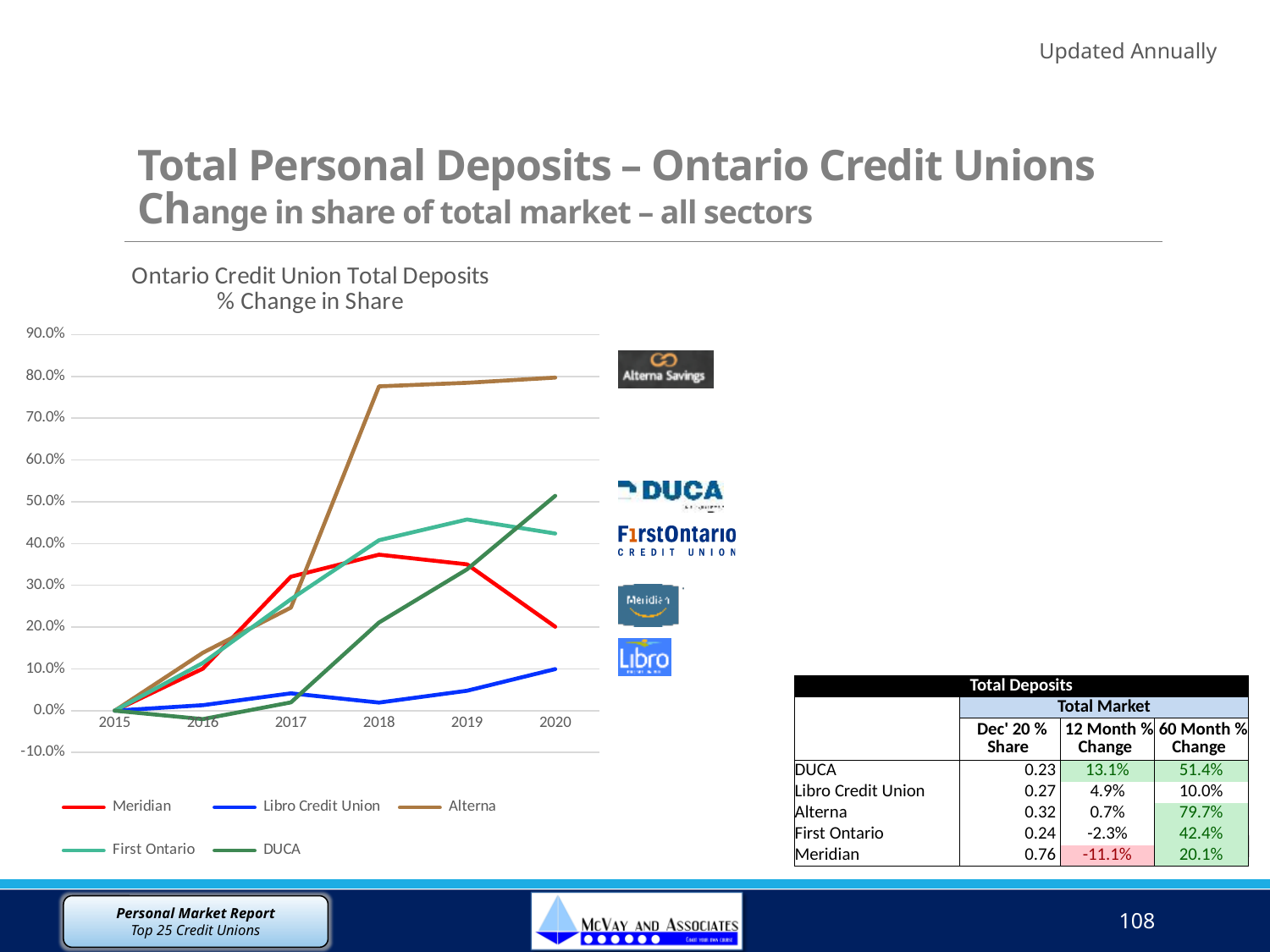
What kind of chart is shown on the slide? line chart Which series has the lowest value in 2020? Libro Credit Union Which series has the highest value in 2020? Alterna What is the title of the chart? Ontario Credit Union Total Deposits % Change in Share How many series does the chart legend list? 5 In 2020, which is larger: the value for DUCA or the value for First Ontario? DUCA In 2018, which is larger: the value for Alterna or the value for Meridian? Alterna How many years are plotted along the x axis of the chart? 6 Is the value for Alterna in 2020 greater or less than 70.0%? greater Is the value for DUCA in 2020 greater or less than 40.0%? greater Is the value for Libro Credit Union in 2020 greater or less than 20.0%? less Does the Meridian line rise or fall between 2019 and 2020? fall